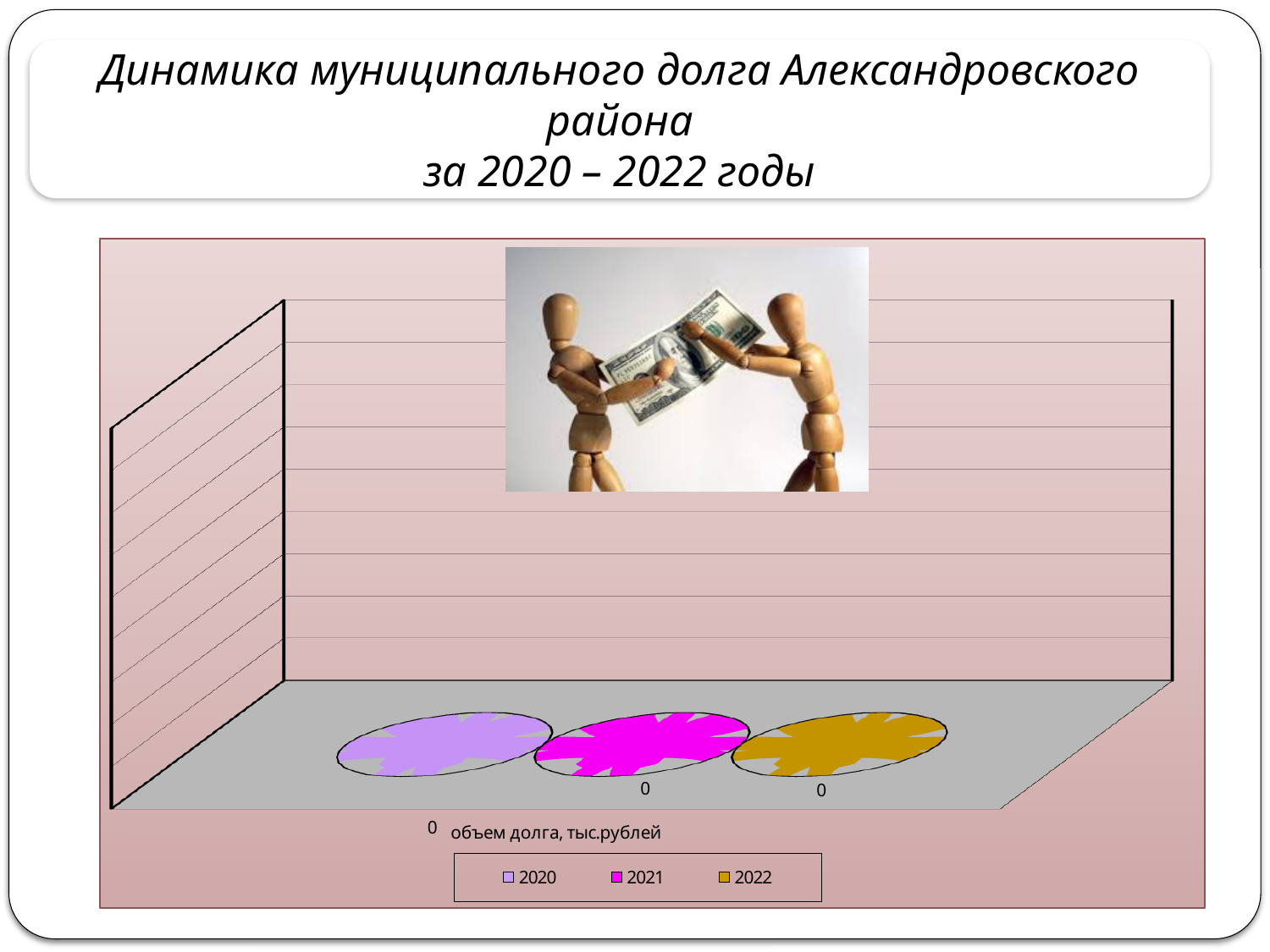
Which series is shown in magenta in the legend? 2021 What is the value for 2020 for объем долга, тыс.рублей? 0 What is the value for 2021 for объем долга, тыс.рублей? 0 What is the difference between the 2021 and 2020 values for объем долга, тыс.рублей? 0 What is the category label on the x axis? объем долга, тыс.рублей How many series does the legend list? 3 What is the value for 2022 for объем долга, тыс.рублей? 0 Do the values rise, fall or stay the same from 2020 to 2022? stay the same What kind of chart is shown on the slide? bar chart What is the title of the slide? Динамика муниципального долга Александровского района за 2020 – 2022 годы How many categories are shown on the x axis? 1 What is the difference between the 2022 and 2021 values for объем долга, тыс.рублей? 0